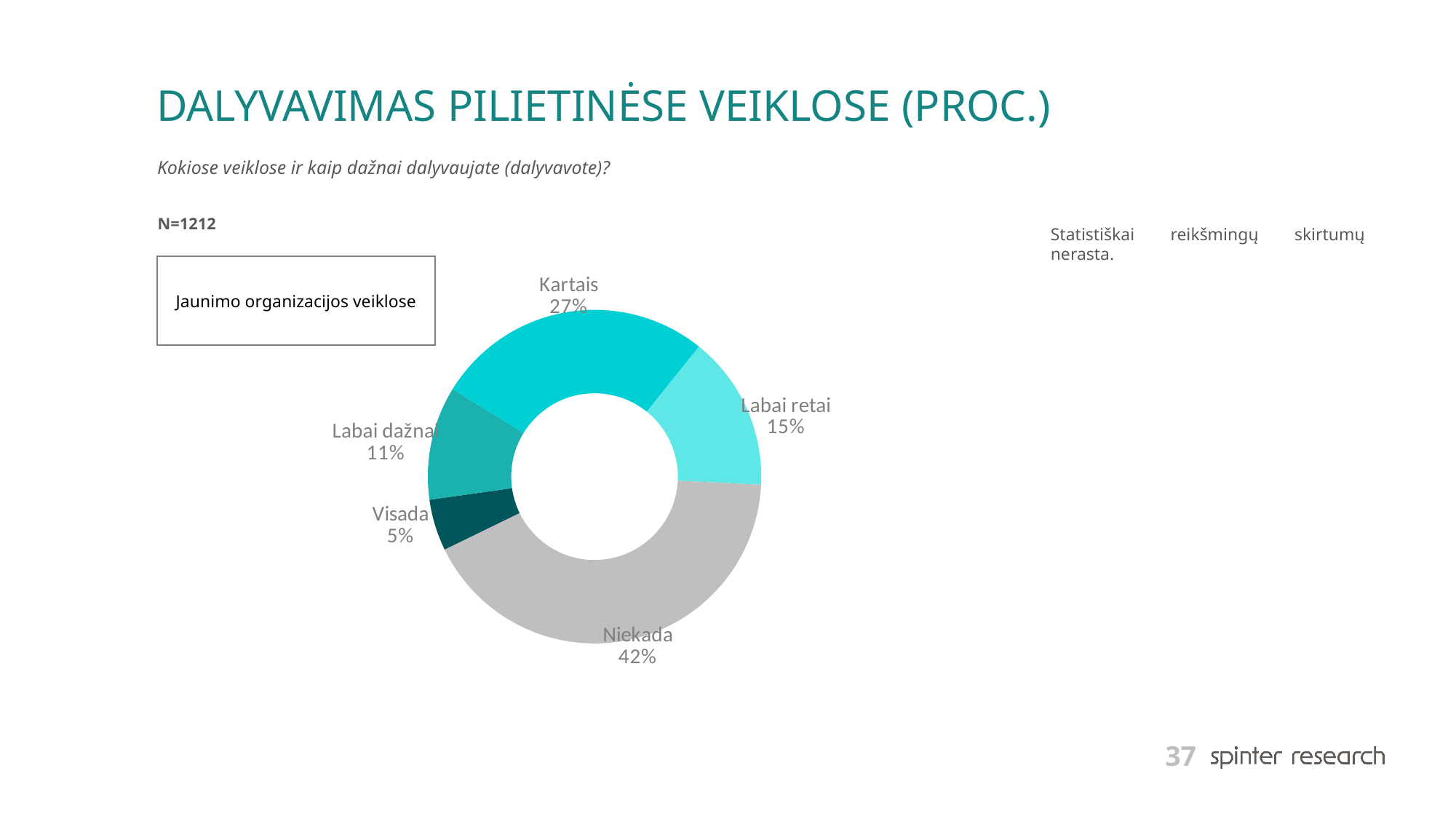
What percentage of respondents answered "Kartais"? 27% What percentage of respondents answered "Niekada"? 42% What percentage of respondents answered "Visada"? 5% What is the difference in percentage points between "Niekada" and "Kartais"? 15 What is the sample size (N) stated on the slide? N=1212 How many categories are shown in the chart? 5 Which is larger, the share for "Labai retai" or the share for "Labai dažnai"? Labai retai What kind of chart is shown on the slide? Doughnut chart What percentage of respondents answered "Labai retai"? 15% Which category has the smallest share of the chart? Visada Which category has the largest share of the chart? Niekada What is the combined share of "Visada" and "Labai dažnai"? 16%